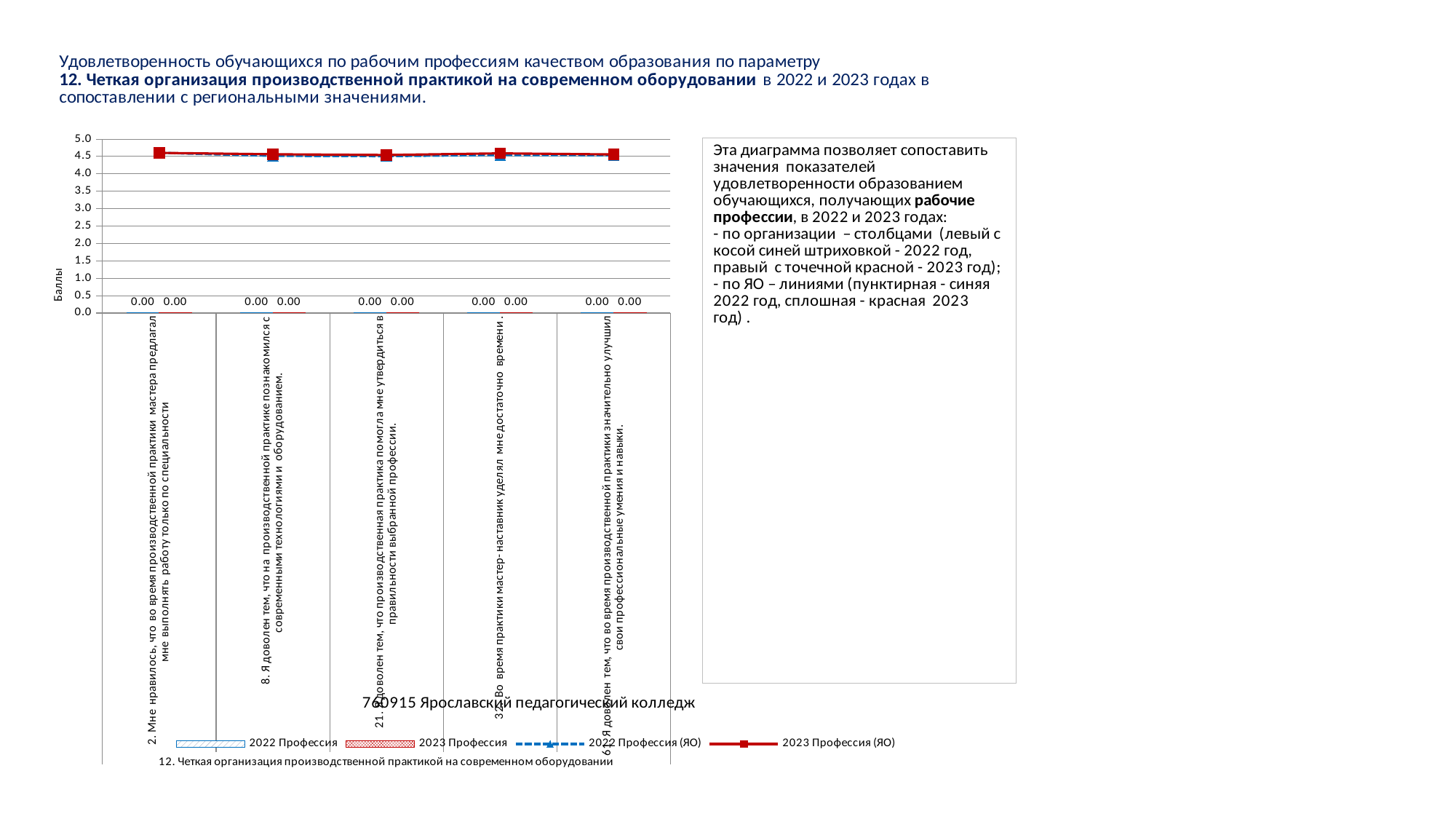
How many categories are shown along the x axis of the chart? 5 What is the label of the vertical axis of the chart? Баллы What is the data label shown for the 2022 Профессия bar for category "32. Во время практики мастер-наставник уделял мне достаточно времени."? 0.00 Is the value of the 2022 Профессия (ЯО) line for the last category ("61. Я доволен тем, что во время производственной практики значительно улучшил свои профессиональные умения и навыки.") greater or less than 3.0? greater Is the value of the 2023 Профессия (ЯО) line for category "21. Я доволен тем, что производственная практика помогла мне утвердиться в правильности выбранной профессии." greater or less than 5.0? less What is the data label shown for the 2022 Профессия bar for category "2. Мне нравилось, что во время производственной практики мастера предлагал мне выполнять работу только по специальности"? 0.00 What kind of chart is shown on the slide? Combined bar and line chart What is the highest value shown on the vertical axis of the chart? 5.0 How many series does the chart legend list? 4 What is the data label shown for the 2023 Профессия bar for category "8. Я доволен тем, что на производственной практике познакомился с современными технологиями и оборудованием."? 0.00 Is the value of the 2023 Профессия (ЯО) line for the first category ("2. Мне нравилось...") greater or less than 4.0? greater